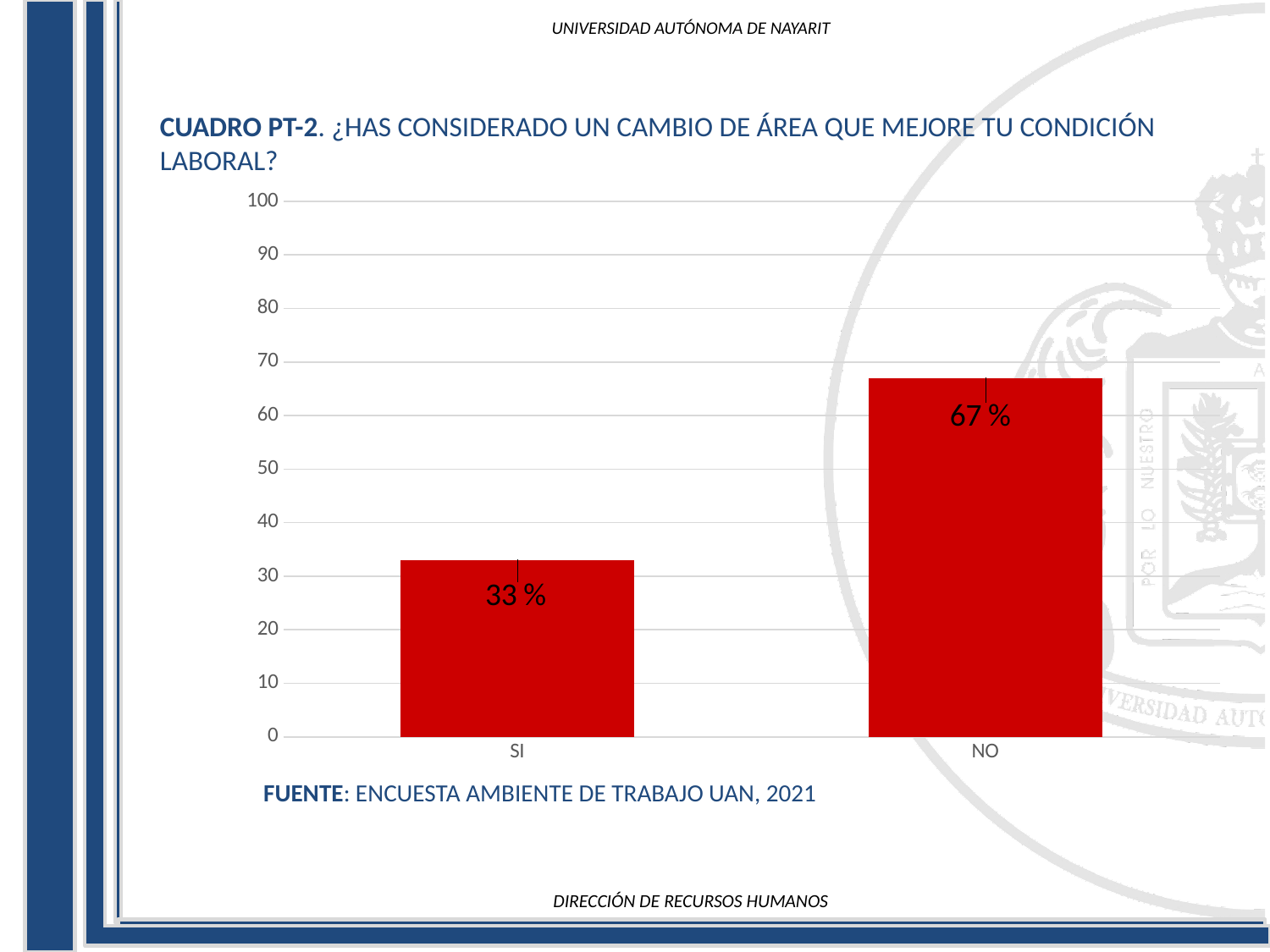
What is the value for SI? 33 % What is the value for NO? 67 % Which is larger, the value for SI or the value for NO? NO How many categories are shown on the x axis? 2 What source is cited below the chart? ENCUESTA AMBIENTE DE TRABAJO UAN, 2021 Is the value for NO greater or less than 60? greater What is the difference between the values for NO and SI? 34 % What kind of chart is shown on the slide? bar chart What is the maximum value shown on the y axis? 100 Is the value for SI greater or less than 40? less Which category has the highest value? NO Which category has the lowest value? SI